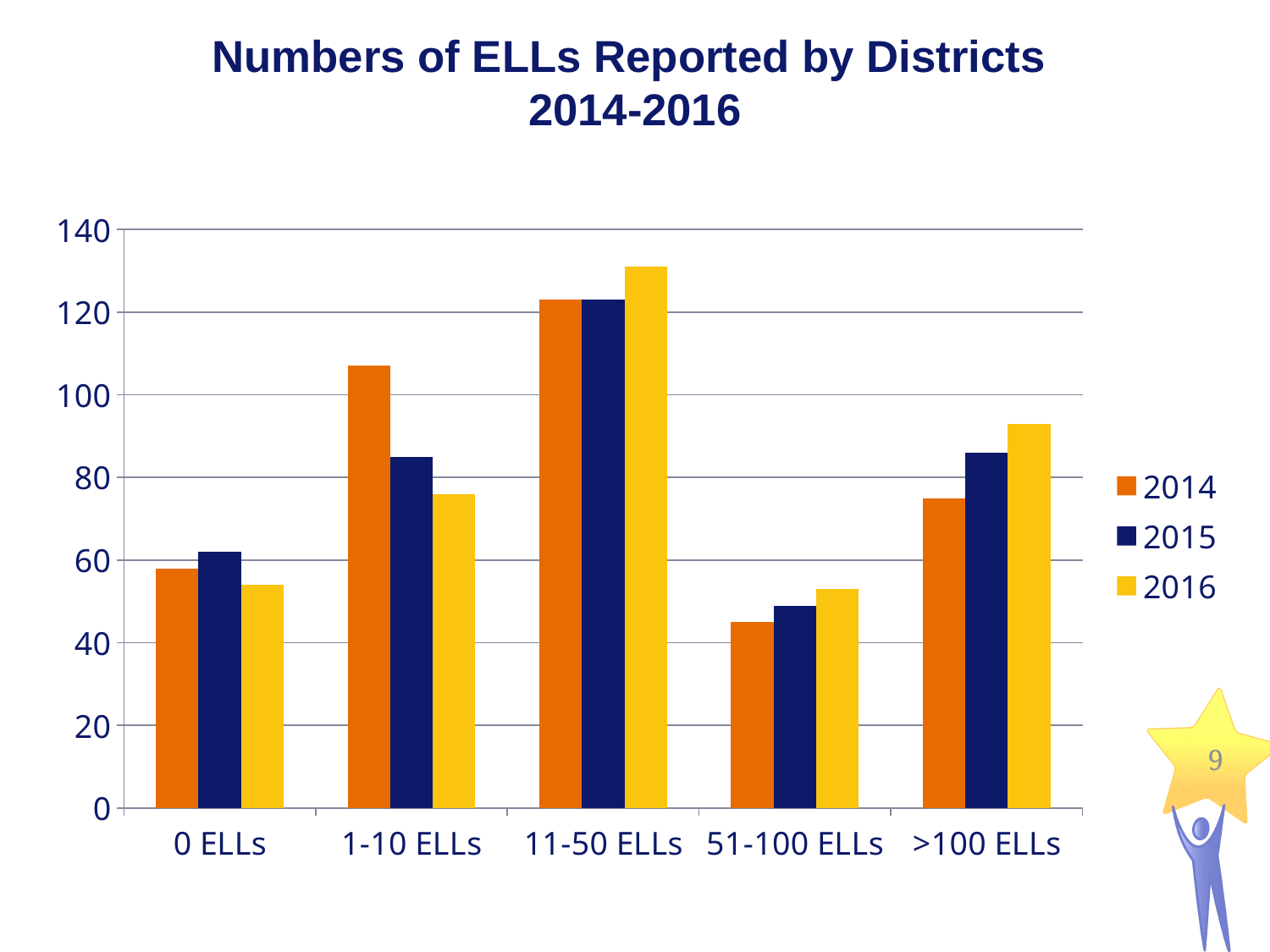
What is the title of the chart? Numbers of ELLs Reported by Districts 2014-2016 What kind of chart is shown on the slide? Bar chart How many series does the legend list? 3 Is the 2014 value for 51-100 ELLs greater or less than 60? less How many ELL categories are shown on the x axis? 5 Which category has the lowest value for 2014? 51-100 ELLs Is the 2014 value for 1-10 ELLs greater or less than 100? greater Is the 2016 value for 11-50 ELLs greater or less than 120? greater Which colour represents 2015 in the legend? Dark blue For the >100 ELLs category, which is larger: the 2014 value or the 2016 value? 2016 For the 1-10 ELLs category, which is larger: the 2014 value or the 2016 value? 2014 Which category has the highest value for 2016? 11-50 ELLs